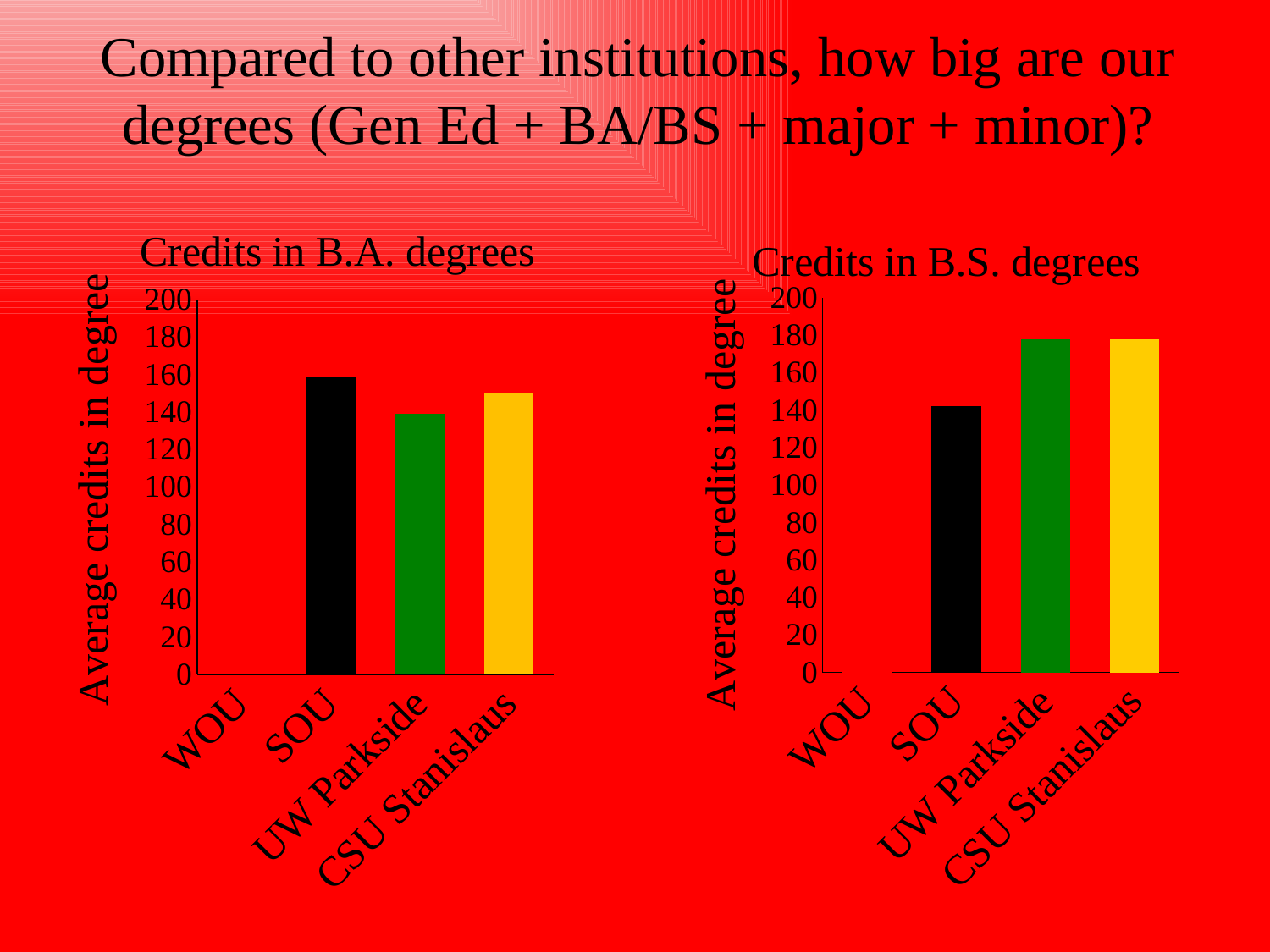
What is the y-axis title of the 'Credits in B.A. degrees' chart? Average credits in degree In the 'Credits in B.A. degrees' chart, which institution has the tallest bar? SOU In the 'Credits in B.A. degrees' chart, is the value for CSU Stanislaus greater or less than 140? greater In the 'Credits in B.S. degrees' chart, is the value for SOU greater or less than 160? less In the 'Credits in B.S. degrees' chart, which is larger, the value for SOU or the value for CSU Stanislaus? CSU Stanislaus In the 'Credits in B.S. degrees' chart, is the value for UW Parkside greater or less than 160? greater In the 'Credits in B.S. degrees' chart, which of the institutions with a visible bar has the shortest bar? SOU In the 'Credits in B.A. degrees' chart, which is larger, the value for SOU or the value for UW Parkside? SOU How many institutions are listed on the x axis of the 'Credits in B.S. degrees' chart? 4 What kind of chart is the 'Credits in B.A. degrees' chart? bar chart